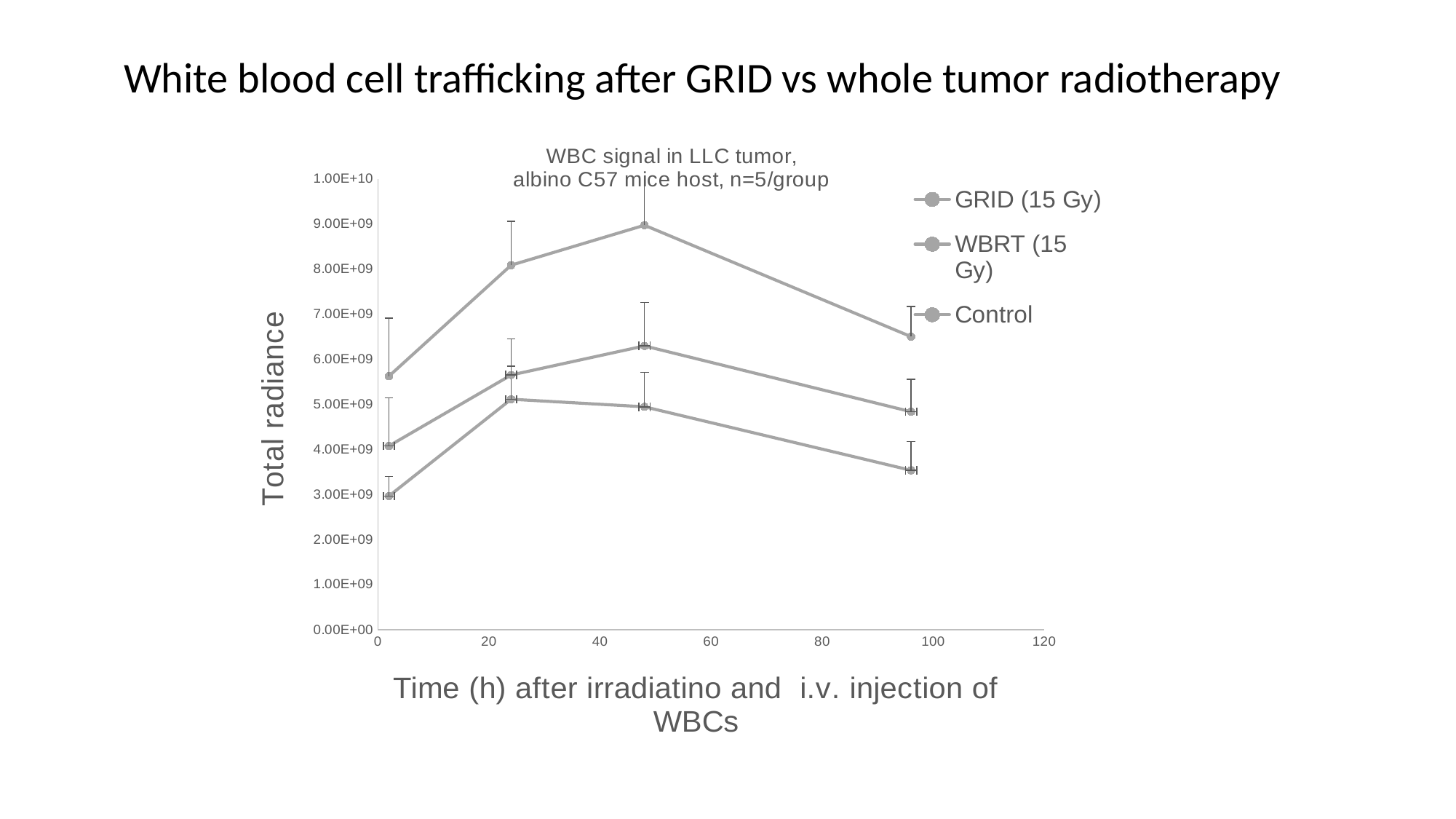
Is the value of the topmost line at about 48 h greater or less than 8.00E+09? greater What kind of chart is shown on the slide? line chart Does the topmost line rise or fall between about 48 h and 96 h? fall How many series does the legend list? 3 What is the title of the chart? WBC signal in LLC tumor, albino C57 mice host, n=5/group How many data points does each line have? 4 Is the value of the lowest line at about 96 h greater or less than 4.00E+09? less What is the y-axis label of the chart? Total radiance Does the lowest line rise or fall between about 2 h and 24 h? rise Is the value of the topmost line at about 96 h greater or less than 6.00E+09? greater At about 48 h, which line is higher: the topmost line or the lowest line? the topmost line